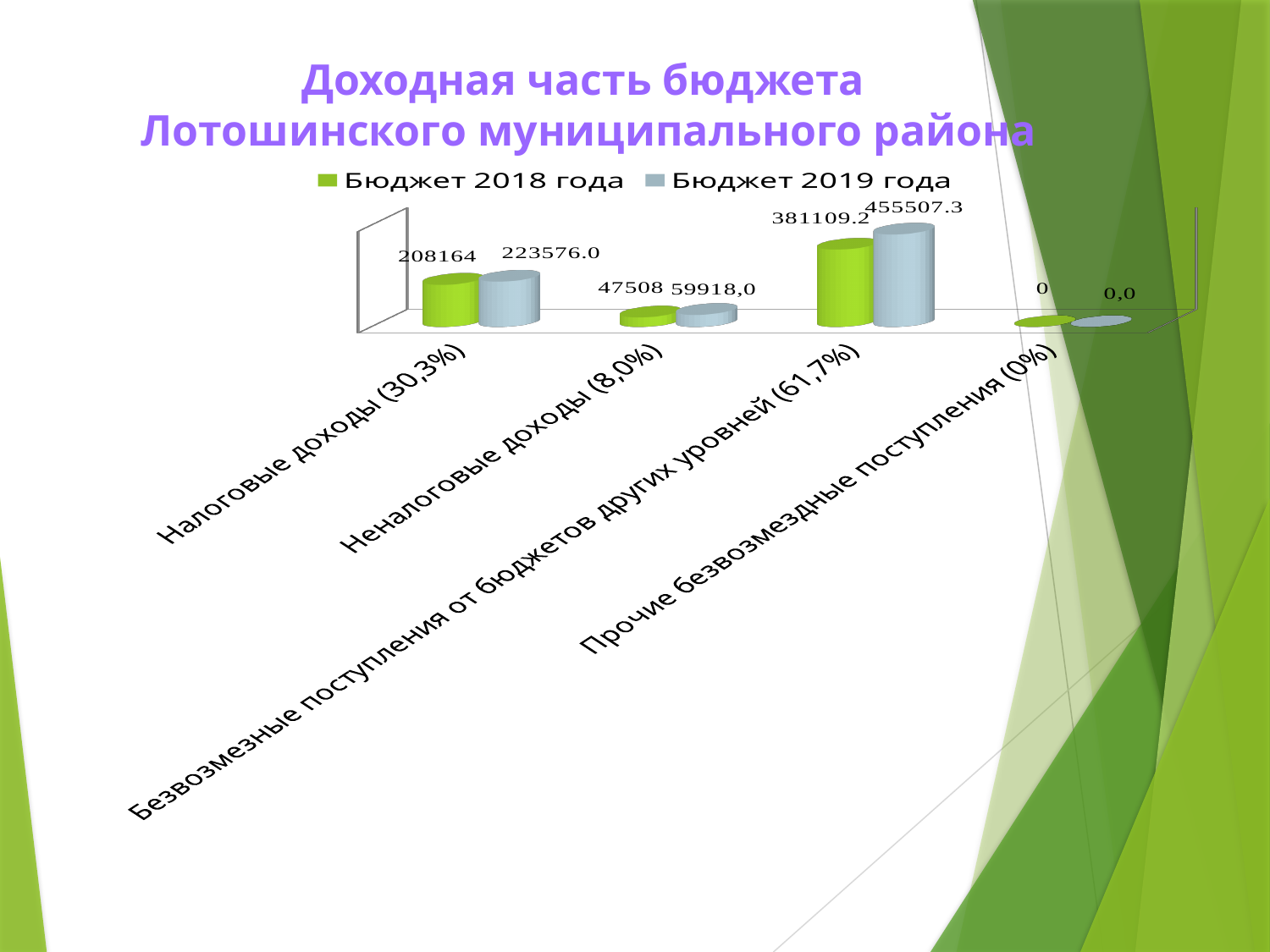
What is the difference between the Бюджет 2019 года and Бюджет 2018 года values for Безвозмездные поступления от бюджетов других уровней (61,7%)? 74398.1 What is the value for Налоговые доходы (30,3%) in the Бюджет 2019 года series? 223576.0 Which category has the highest value in the Бюджет 2019 года series? Безвозмездные поступления от бюджетов других уровней (61,7%) Which category has the lowest value in the Бюджет 2018 года series? Прочие безвозмездные поступления (0%) How many categories are shown on the x axis? 4 Which series has the larger value for Неналоговые доходы (8,0%)? Бюджет 2019 года What is the value for Неналоговые доходы (8,0%) in the Бюджет 2018 года series? 47508 What kind of chart is shown on the slide? bar chart What is the value for Налоговые доходы (30,3%) in the Бюджет 2018 года series? 208164 What is the value for Безвозмездные поступления от бюджетов других уровней (61,7%) in the Бюджет 2019 года series? 455507.3 What is the value for Прочие безвозмездные поступления (0%) in the Бюджет 2018 года series? 0 How many series does the legend list? 2